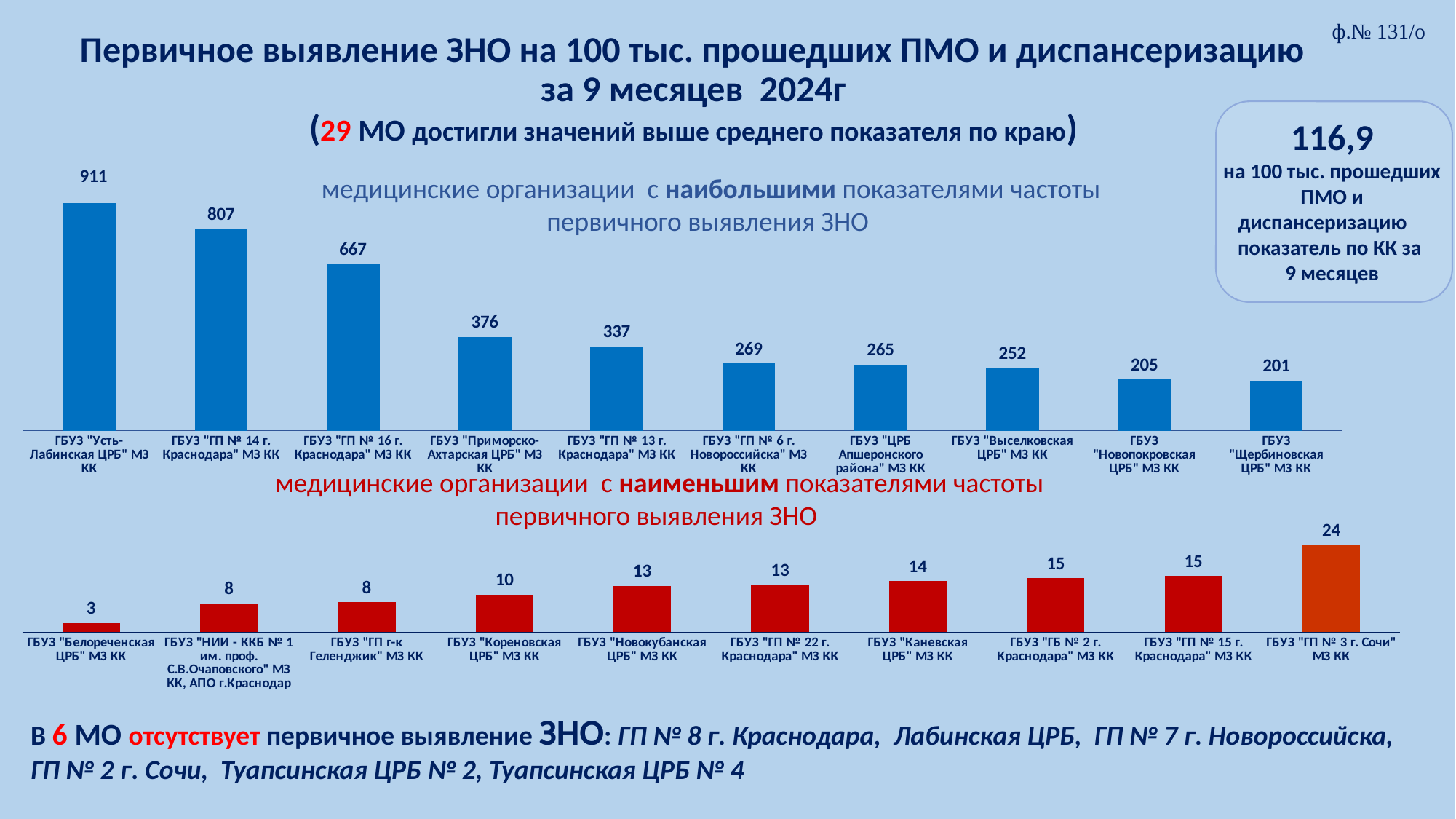
In the top chart, what is the value for ГБУЗ "Усть-Лабинская ЦРБ" МЗ КК? 911 Do the values in the top chart rise or fall from left to right? fall In the bottom chart, which organisation has the lowest value? ГБУЗ "Белореченская ЦРБ" МЗ КК In the top chart, which organisation has the lowest value? ГБУЗ "Щербиновская ЦРБ" МЗ КК In the top chart, what is the value for ГБУЗ "ГП № 16 г. Краснодара" МЗ КК? 667 In the top chart, what is the difference between the values for ГБУЗ "ГП № 14 г. Краснодара" МЗ КК and ГБУЗ "Приморско-Ахтарская ЦРБ" МЗ КК? 431 In the bottom chart, what is the value for ГБУЗ "ГП № 3 г. Сочи" МЗ КК? 24 In the bottom chart, which is larger: the value for ГБУЗ "Кореновская ЦРБ" МЗ КК or ГБУЗ "Каневская ЦРБ" МЗ КК? ГБУЗ "Каневская ЦРБ" МЗ КК What type of chart is the bottom chart? bar chart In the bottom chart, what colour is the bar for ГБУЗ "ГП № 3 г. Сочи" МЗ КК? orange In the bottom chart, what is the difference between the values for ГБУЗ "ГП № 3 г. Сочи" МЗ КК and ГБУЗ "Белореченская ЦРБ" МЗ КК? 21 How many organisations are shown in the top chart? 10